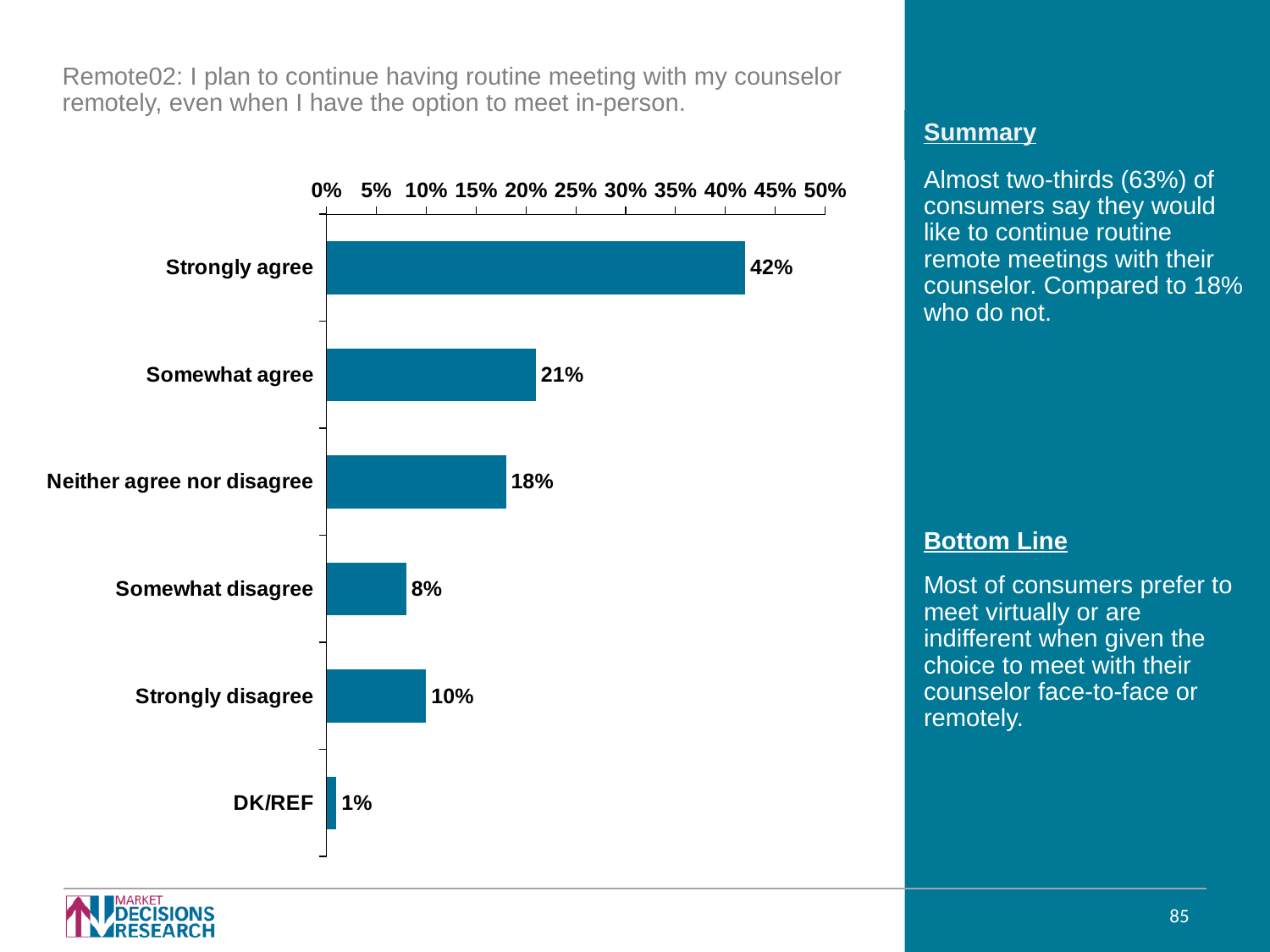
What type of chart is shown on the slide? Bar chart What percentage of respondents selected "Strongly disagree"? 10% Which is larger, the value for "Somewhat disagree" or the value for "Strongly disagree"? Strongly disagree Is the value for "Somewhat agree" greater or less than 25%? less Which response category has the highest percentage? Strongly agree Which response category has the lowest percentage? DK/REF What is the value shown for "DK/REF"? 1% What is the difference in percentage points between "Strongly agree" and "Somewhat agree"? 21 What percentage of respondents selected "Strongly agree"? 42% How many response categories are shown in the chart? 6 What is the value shown for "Neither agree nor disagree"? 18% What is the maximum value shown on the percentage axis? 50%